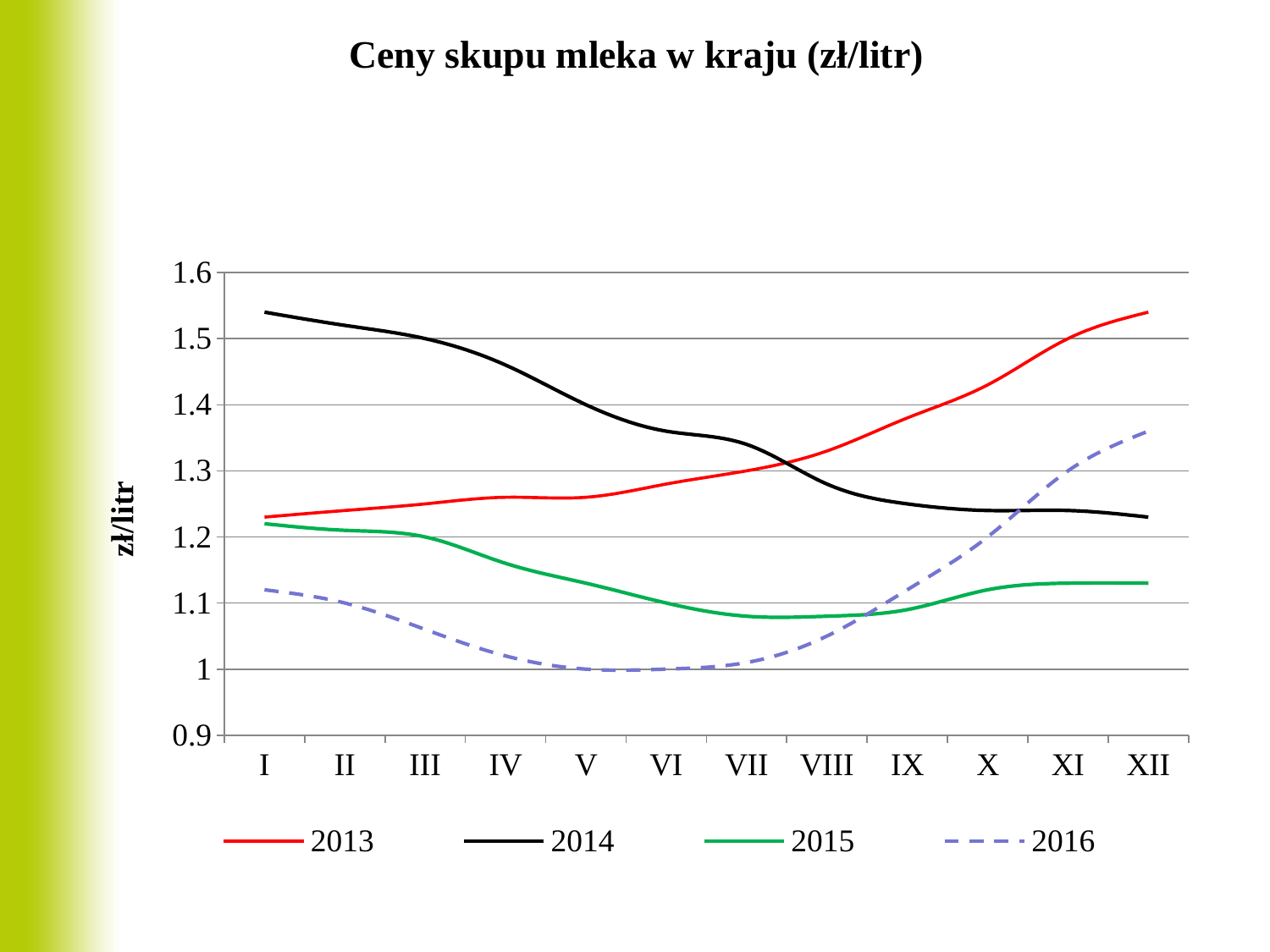
Which series is drawn with a dashed line? 2016 Is the 2014 value in month I greater or less than 1.5? greater What kind of chart is shown on the slide? line chart Which year has the highest price in month I? 2014 Does the 2014 line generally rise or fall from month I to month XII? fall Is the 2016 value in month XII greater or less than 1.3? greater What is the title of the chart? Ceny skupu mleka w kraju (zł/litr) How many series does the legend list? 4 Which year has the lowest price in month XII? 2015 In month XII, which is higher: the 2013 value or the 2014 value? 2013 How many months are shown along the x axis? 12 Is the 2015 value in month VII greater or less than 1.1? less